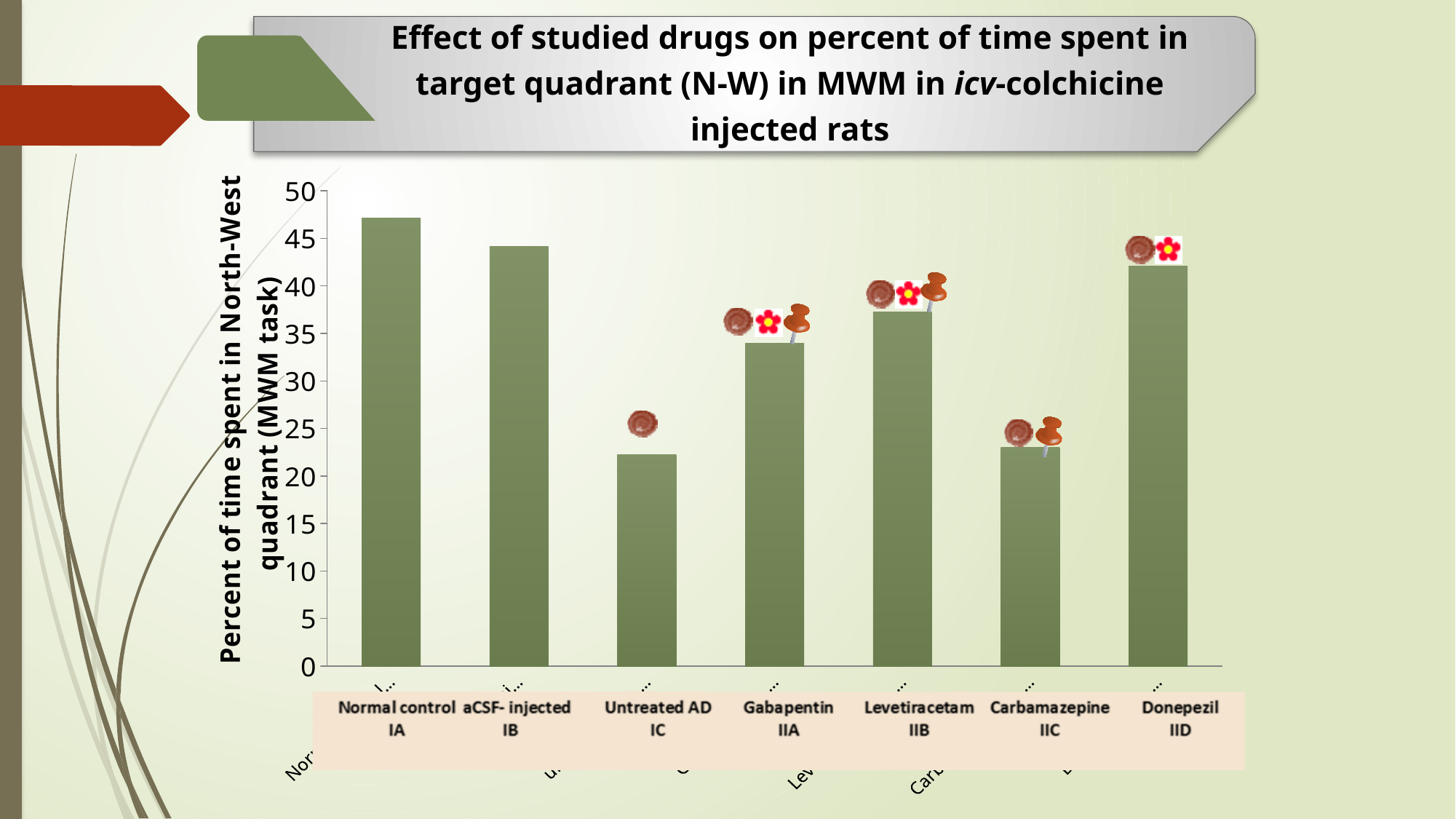
Is the value for Levetiracetam IIB greater or less than 35? greater Is the value for Normal control IA greater or less than 45? greater Is the value for Donepezil IID greater or less than 40? greater How many groups (bars) are plotted in the chart? 7 Which has a higher value, Levetiracetam IIB or Carbamazepine IIC? Levetiracetam IIB Which has a higher value, Donepezil IID or Gabapentin IIA? Donepezil IID What is the label of the vertical axis? Percent of time spent in North-West quadrant (MWM task) What kind of chart is shown on the slide? bar chart Which group has the highest percent of time spent in the North-West quadrant? Normal control IA